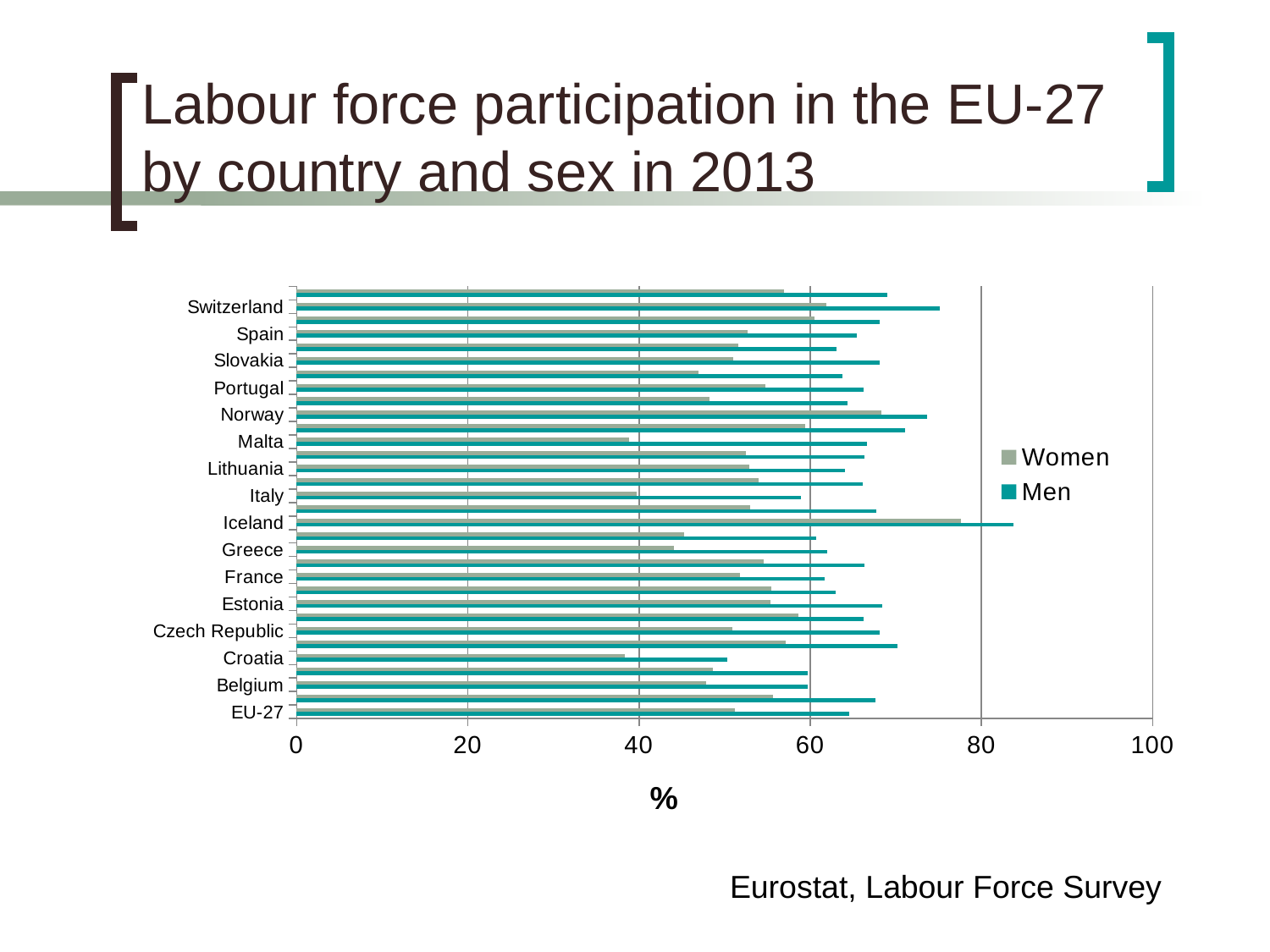
Which country has the highest value for Men? Iceland Which country has the highest value for Women? Iceland Is the value for Men in Croatia greater or less than 60? less How many series does the legend list? 2 Is the value for Women in Iceland greater or less than 60? greater Which is larger for Italy, the value for Men or the value for Women? Men Is the value for Men in Iceland greater or less than 80? greater What kind of chart is shown on the slide? Bar chart What are the two series named in the legend? Women and Men Which is larger, the value for Women in Iceland or the value for Women in Malta? Iceland What is the label on the horizontal axis? %